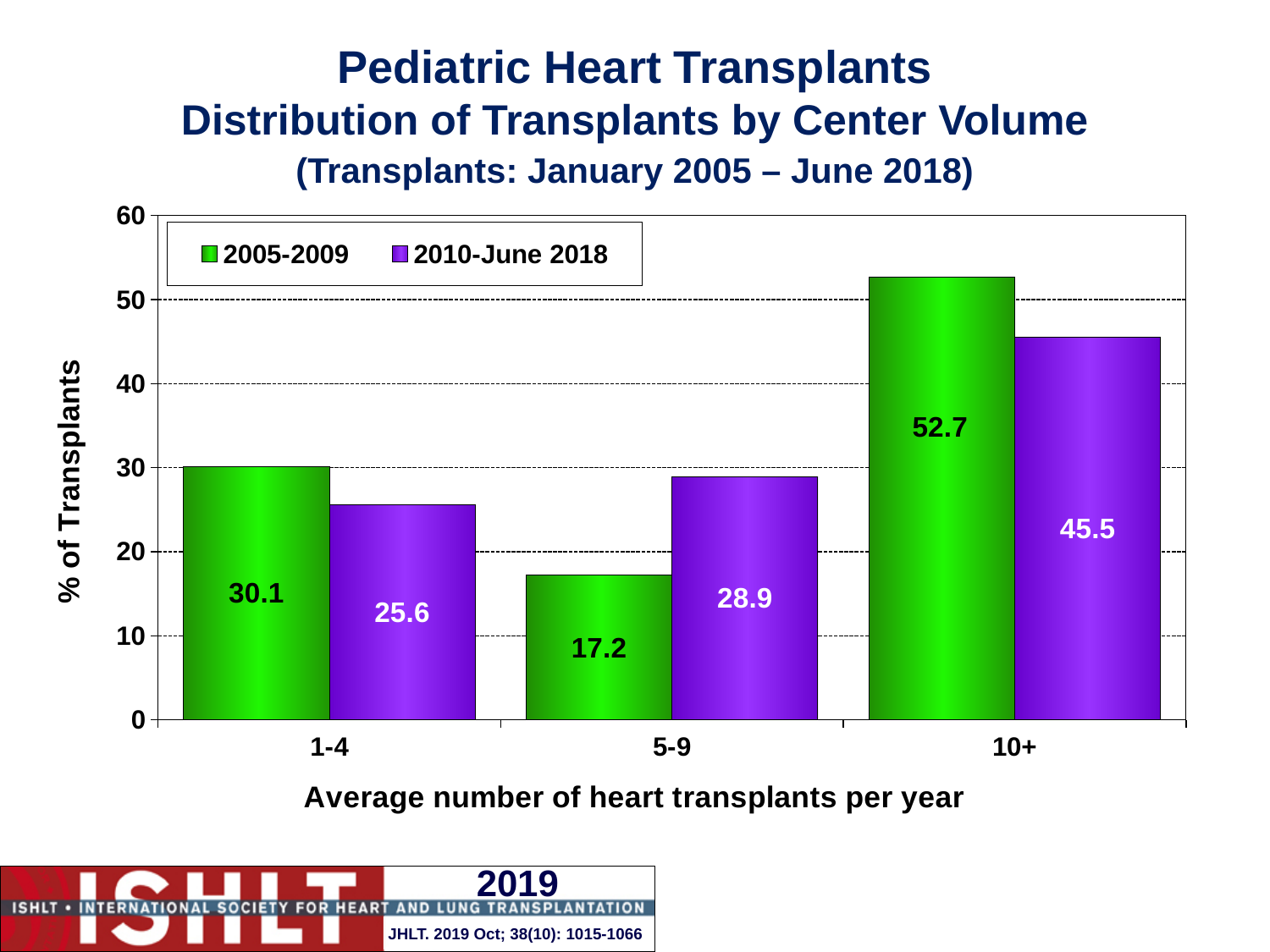
What is the value for the 2010-June 2018 series in the 10+ category? 45.5 How many series does the legend list? 2 What kind of chart is shown on the slide? bar chart What is the value for the 2005-2009 series in the 1-4 category? 30.1 Is the value for the 2005-2009 series in the 5-9 category greater or less than 20? less Which category has the lowest value for the 2010-June 2018 series? 1-4 Which category has the highest value for the 2005-2009 series? 10+ What is the difference between the 2005-2009 and 2010-June 2018 values in the 10+ category? 7.2 What is the label of the y axis? % of Transplants What is the value for the 2010-June 2018 series in the 5-9 category? 28.9 How many categories are shown on the x axis? 3 In the 5-9 category, which series has the larger value, 2005-2009 or 2010-June 2018? 2010-June 2018